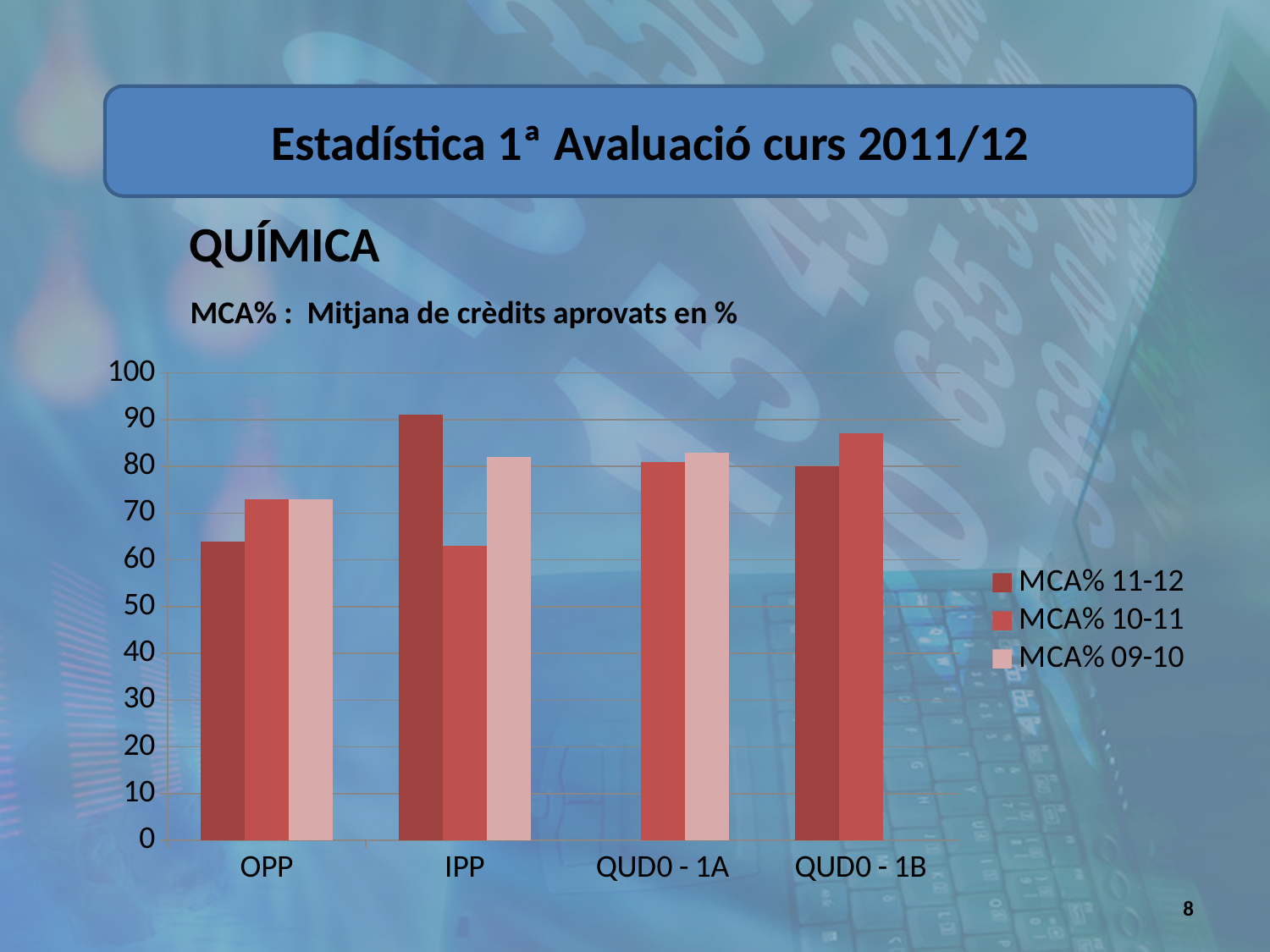
Which category has the lowest MCA% 11-12 bar? OPP How many series does the chart's legend list? 3 Which category has the highest MCA% 11-12 bar? IPP For IPP, which is larger: MCA% 11-12 or MCA% 10-11? MCA% 11-12 Is the MCA% 11-12 value for OPP greater or less than 70? less Which category has no MCA% 11-12 bar? QUD0 - 1A Which category has the lowest MCA% 10-11 bar? IPP How many categories are shown on the x axis of the chart? 4 For OPP, which is larger: MCA% 11-12 or MCA% 10-11? MCA% 10-11 Is the MCA% 10-11 value for QUD0 - 1B greater or less than 80? greater What kind of chart is shown on the slide? bar chart Which category has the highest MCA% 10-11 bar? QUD0 - 1B